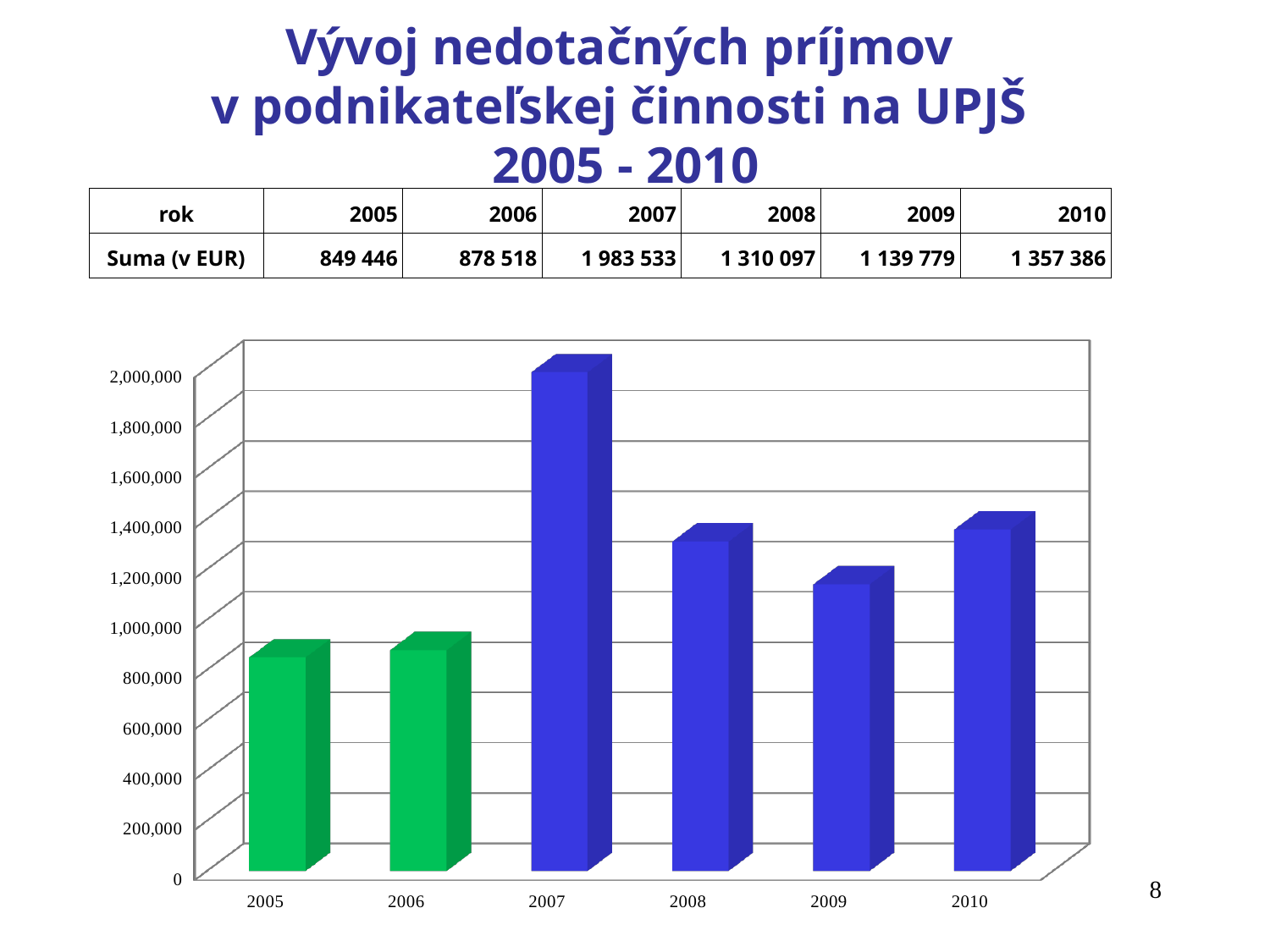
How many years are shown on the x axis of the chart? 6 Which year has the highest value? 2007 What is the difference between the values for 2007 and 2005? 1 134 087 Which is larger, the value for 2009 or the value for 2006? 2009 Is the value for 2009 greater or less than 1,000,000? greater What kind of chart is shown on the slide? bar chart What is the value for 2007? 1 983 533 What colour are the bars for 2005 and 2006? green Is the value for 2005 greater or less than 1,000,000? less What is the value for 2009 (Suma v EUR)? 1 139 779 Which year has the lowest value? 2005 What is the difference between the values for 2010 and 2008? 47 289